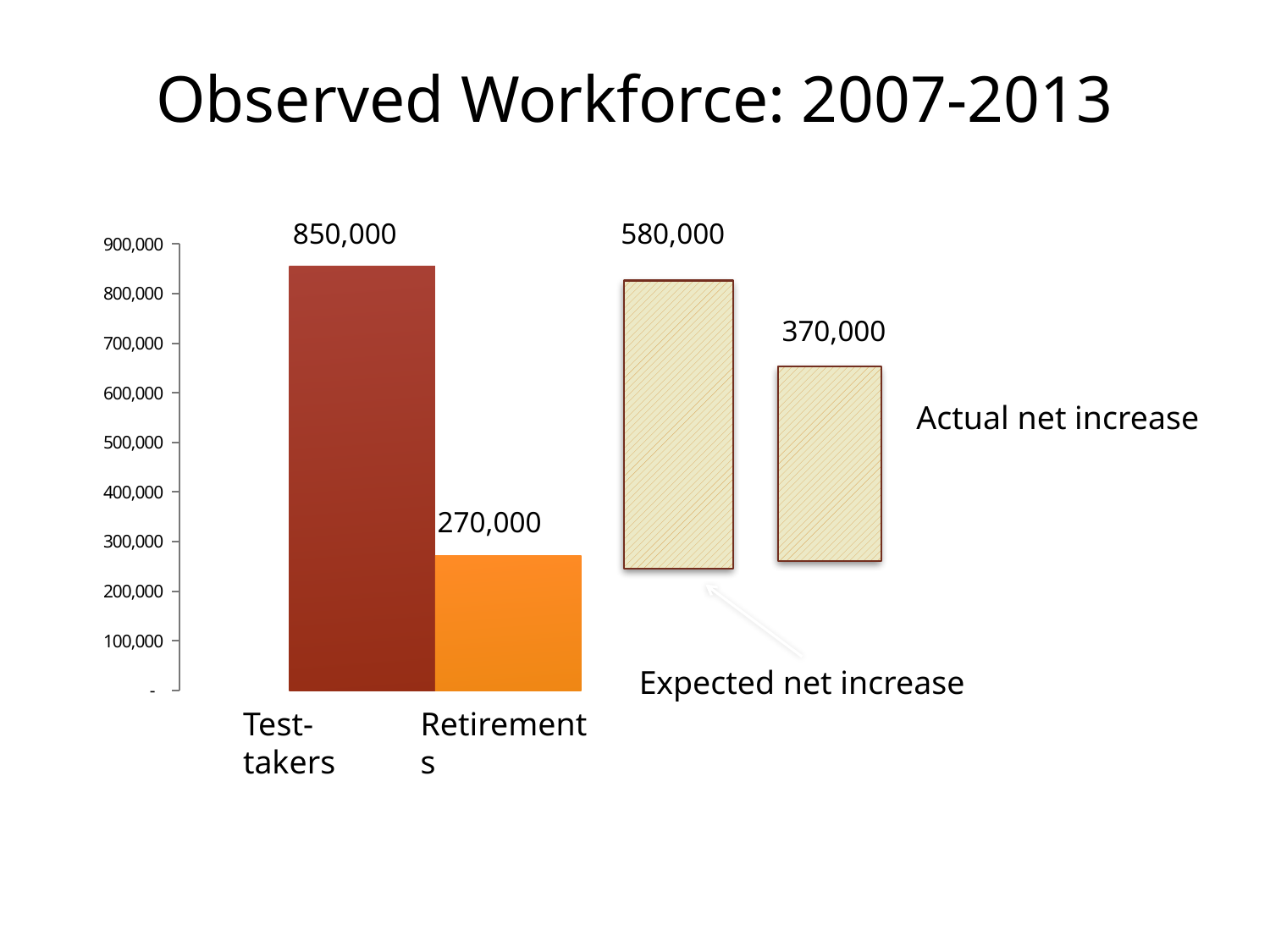
What is the difference between the Test-takers value and the Retirements value? 580,000 What is the title of the slide? Observed Workforce: 2007-2013 Is the value for Test-takers greater or less than 800,000? greater Is the value for Retirements greater or less than 300,000? less What value is shown for the expected net increase? 580,000 What is the highest value shown on the vertical axis? 900,000 What is the value for Test-takers? 850,000 What kind of chart is shown on the slide? bar chart What is the value for Retirements? 270,000 What is the difference between the expected net increase and the actual net increase? 210,000 What value is shown for the actual net increase? 370,000 Which bar is higher, Test-takers or Retirements? Test-takers